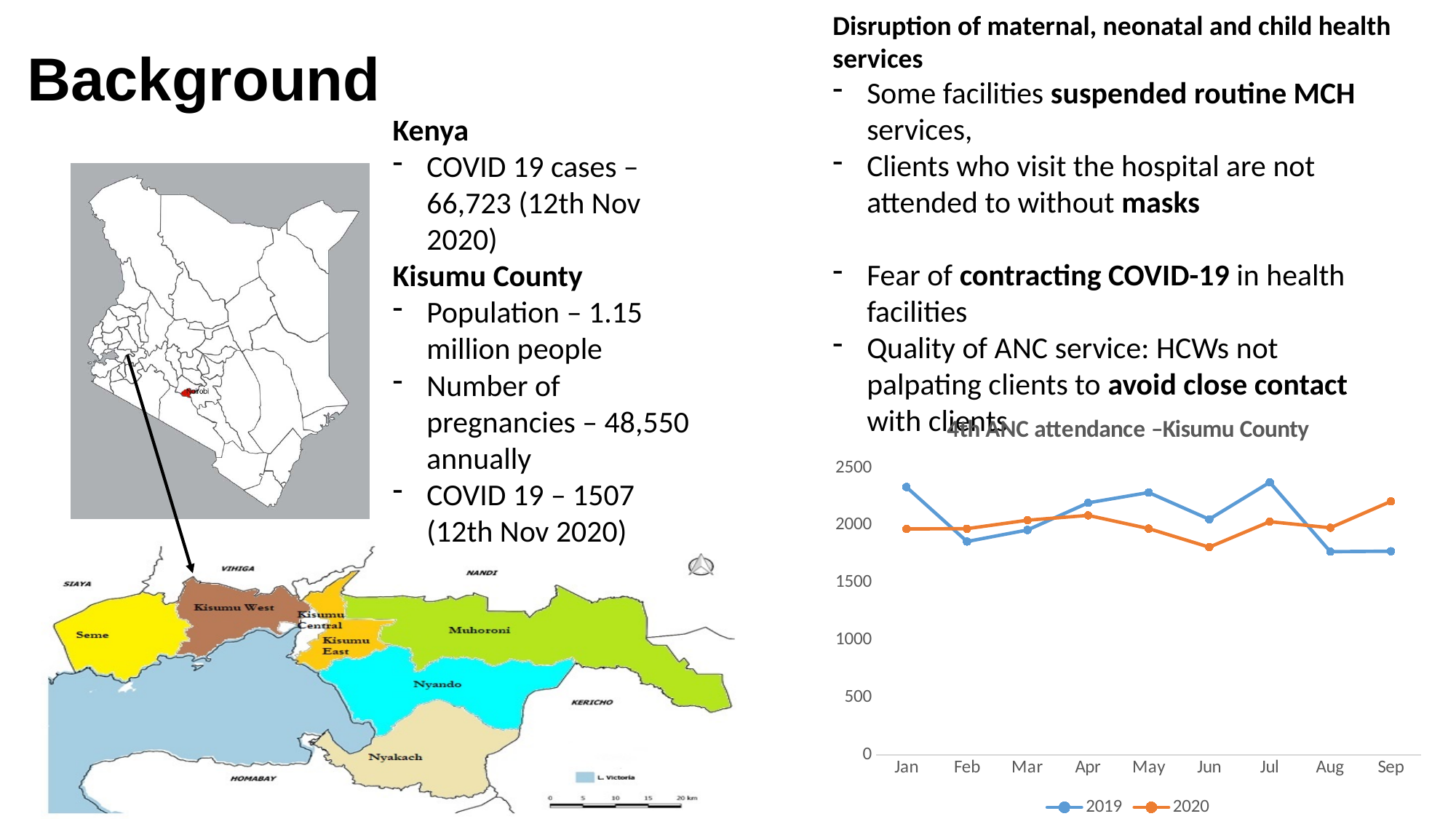
In the '4th ANC attendance –Kisumu County' chart, is the 2019 value for Jan greater or less than 2000? greater In the '4th ANC attendance –Kisumu County' chart, which series has the larger value in Jan, 2019 or 2020? 2019 How many series does the legend of the '4th ANC attendance –Kisumu County' chart list? 2 In the '4th ANC attendance –Kisumu County' chart, is the 2020 value for Sep greater or less than 2000? greater How many months are shown on the x axis of the '4th ANC attendance –Kisumu County' chart? 9 In the '4th ANC attendance –Kisumu County' chart, which series has the larger value in Sep, 2019 or 2020? 2020 What kind of chart is the '4th ANC attendance –Kisumu County' chart? line chart In the '4th ANC attendance –Kisumu County' chart, which month has the lowest value for 2020? Jun In the '4th ANC attendance –Kisumu County' chart, is the 2019 value for Aug greater or less than 2000? less In the '4th ANC attendance –Kisumu County' chart, which colour represents the 2020 series? orange In the '4th ANC attendance –Kisumu County' chart, does the 2019 line rise or fall from Jul to Aug? fall In the '4th ANC attendance –Kisumu County' chart, which month has the highest value for 2020? Sep